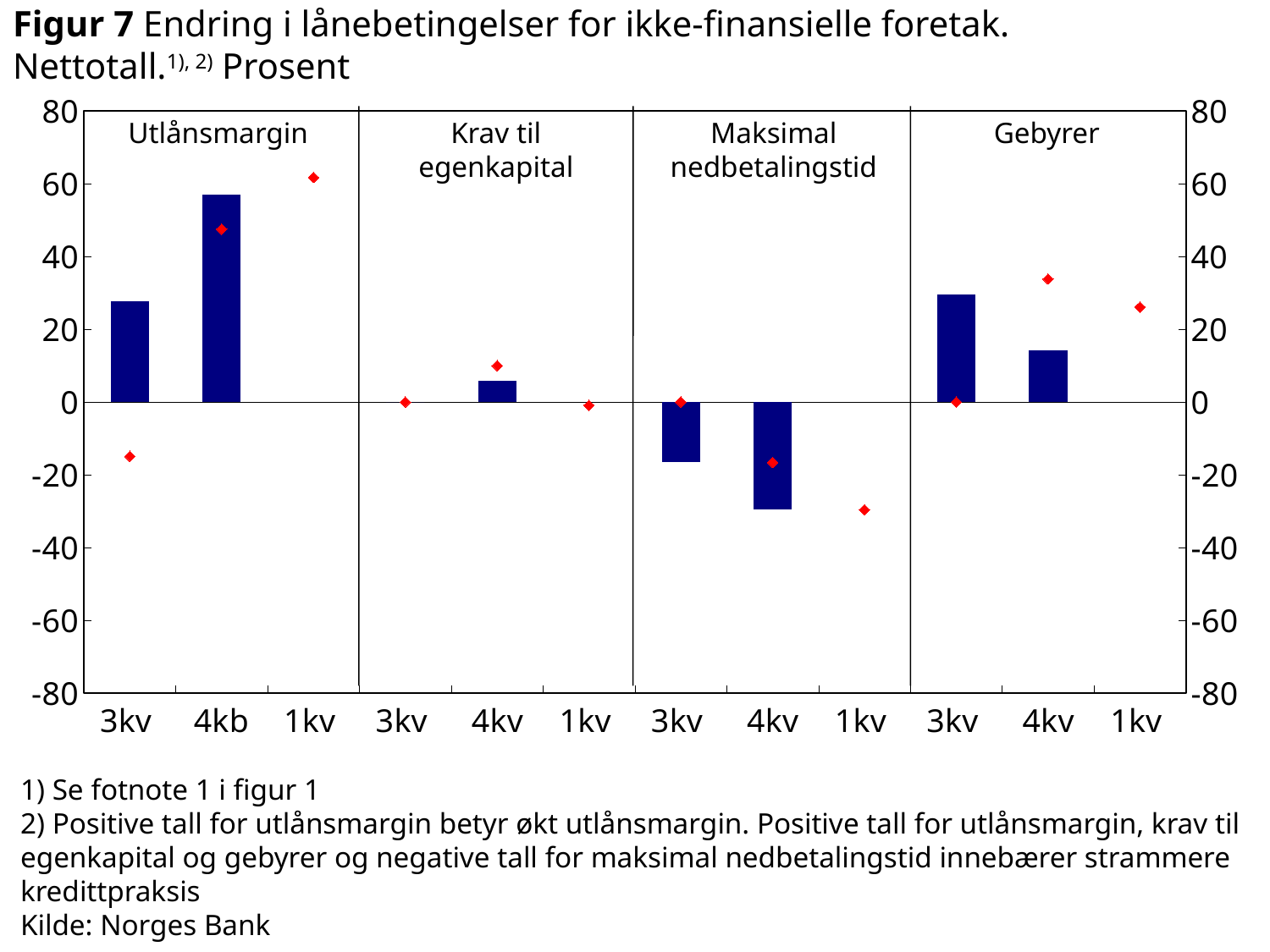
In the Utlånsmargin panel, is the bar for 4kb greater or less than 40? greater Which panel contains the tallest bar in the chart? Utlånsmargin In the Utlånsmargin panel, is the bar for 3kv greater or less than 20? greater What kind of chart is shown in Figur 7? combination chart with bars and point markers In the Maksimal nedbetalingstid panel, is the bar for 4kv greater or less than -20? less Which panel is positioned furthest to the right in the chart? Gebyrer In the Gebyrer panel, which bar is larger, 3kv or 4kv? 3kv Which panel contains the lowest (most negative) bar in the chart? Maksimal nedbetalingstid How many panels (lending-condition categories) does the chart have? 4 In the Utlånsmargin panel, do the bars rise or fall from 3kv to 4kb? rise